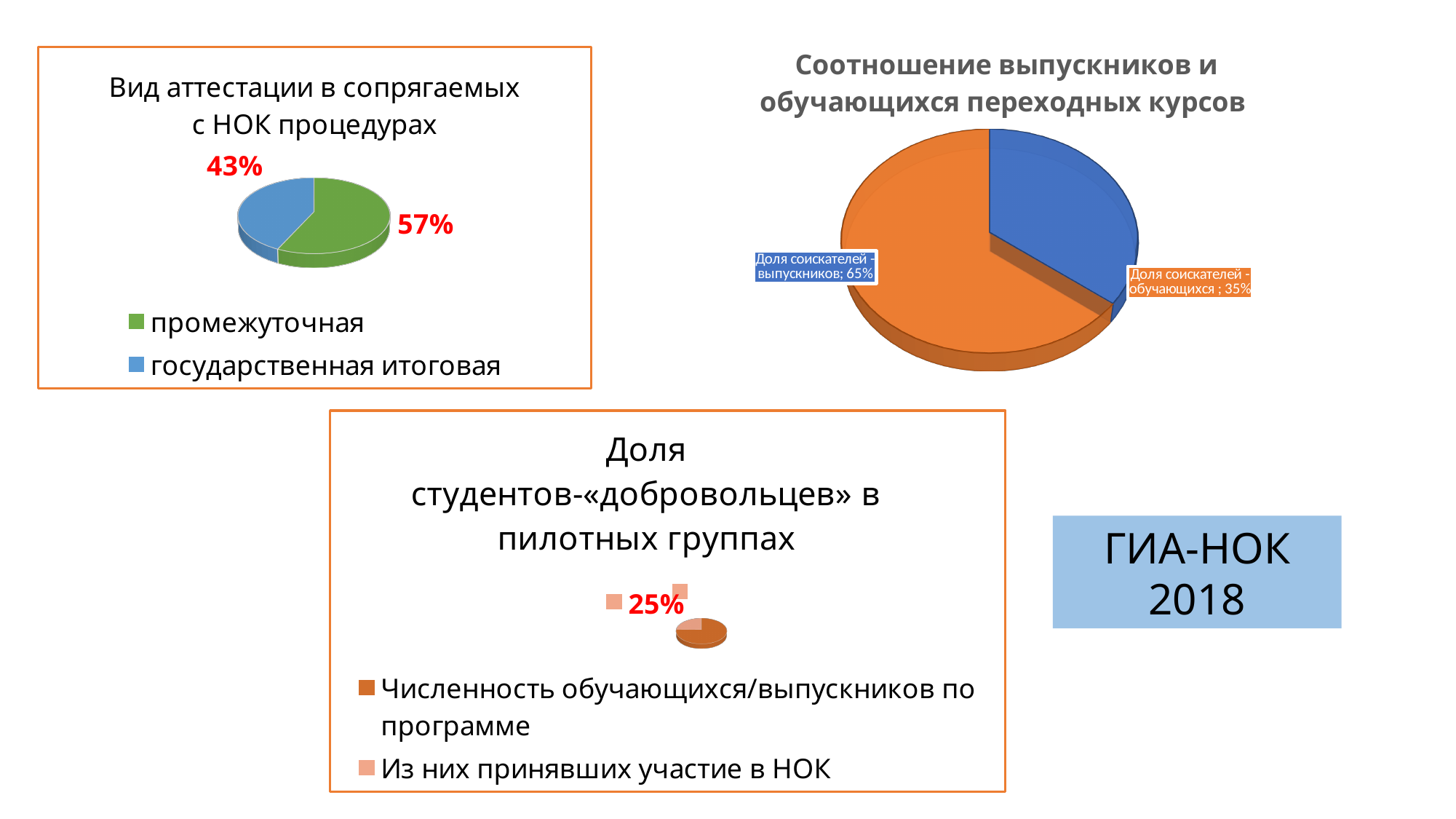
In the chart titled "Соотношение выпускников и обучающихся переходных курсов", what share is shown for "Доля соискателей - обучающихся"? 35% In the chart titled "Вид аттестации в сопрягаемых с НОК процедурах", what share is shown for "государственная итоговая"? 43% In the chart titled "Вид аттестации в сопрягаемых с НОК процедурах", what share is shown for "промежуточная"? 57% In the chart titled "Вид аттестации в сопрягаемых с НОК процедурах", what is the difference in percentage points between "промежуточная" and "государственная итоговая"? 14 In the chart titled "Доля студентов-«добровольцев» в пилотных группах", what share is labelled for "Из них принявших участие в НОК"? 25% In the chart titled "Вид аттестации в сопрягаемых с НОК процедурах", which category has the larger share? промежуточная How many entries does the legend of the chart titled "Доля студентов-«добровольцев» в пилотных группах" list? 2 In the chart titled "Вид аттестации в сопрягаемых с НОК процедурах", what colour represents "государственная итоговая"? Blue In the chart titled "Соотношение выпускников и обучающихся переходных курсов", which category has the smaller share? Доля соискателей - обучающихся In the chart titled "Соотношение выпускников и обучающихся переходных курсов", what is the difference in percentage points between the two slices? 30 What kind of chart is the one titled "Соотношение выпускников и обучающихся переходных курсов"? Pie chart In the chart titled "Соотношение выпускников и обучающихся переходных курсов", what share is shown for "Доля соискателей - выпускников"? 65%